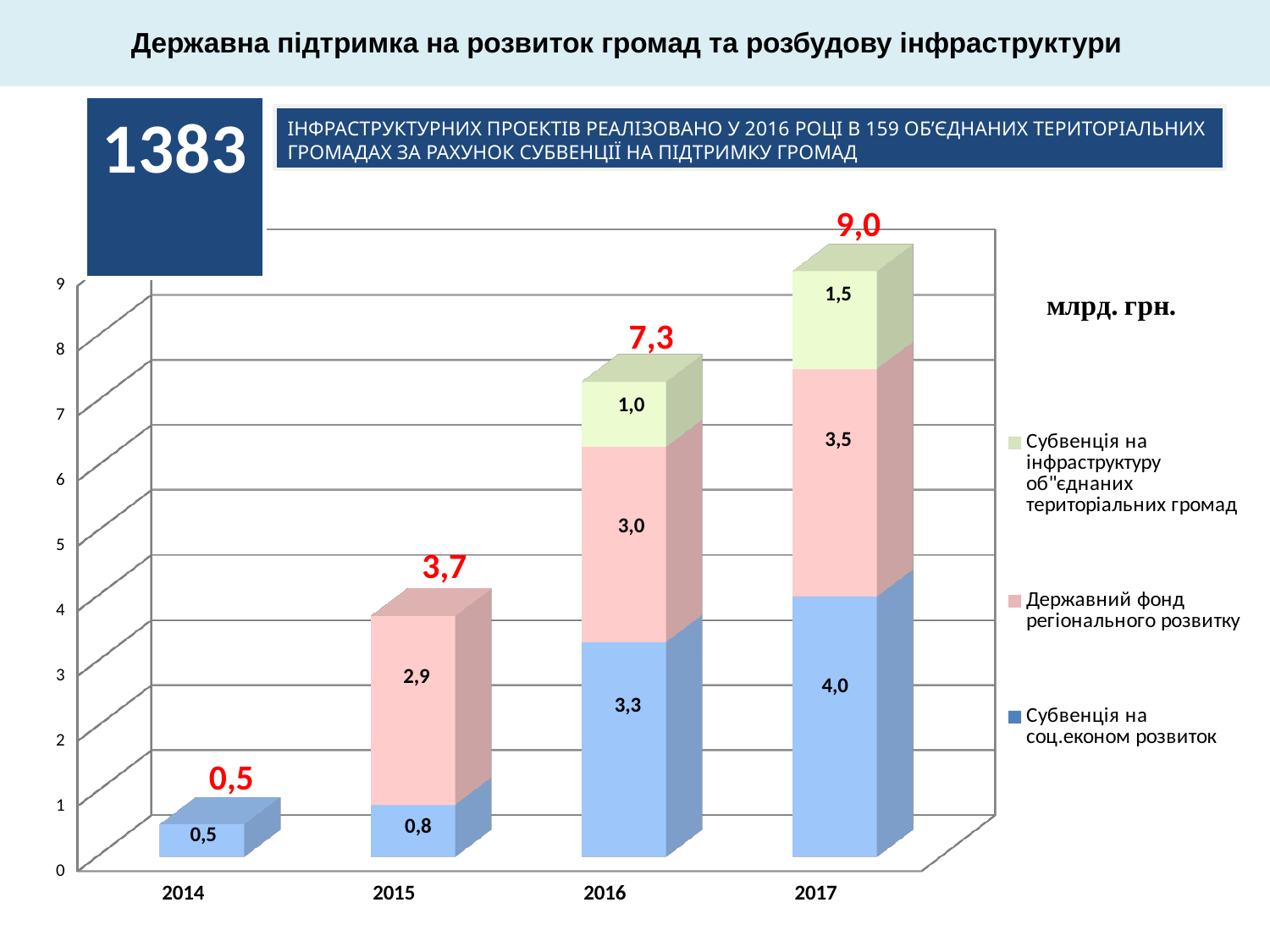
How many series does the chart legend list? 3 How many years (categories) are shown on the x axis of the chart? 4 What is the difference between the total for 2017 and the total for 2016? 1,7 Which is larger: 'Державний фонд регіонального розвитку' in 2016 or in 2017? 2017 What is the total value shown above the bar for 2017? 9,0 What is the value of 'Субвенція на соц.економ розвиток' for 2016? 3,3 Which year has the lowest total value in the chart? 2014 What type of chart is shown on the slide? Stacked bar chart Do the total values rise or fall from 2014 to 2017? Rise What is the value of 'Державний фонд регіонального розвитку' for 2015? 2,9 What is the value of 'Субвенція на інфраструктуру об"єднаних територіальних громад' for 2017? 1,5 Which year has the highest total value in the chart? 2017